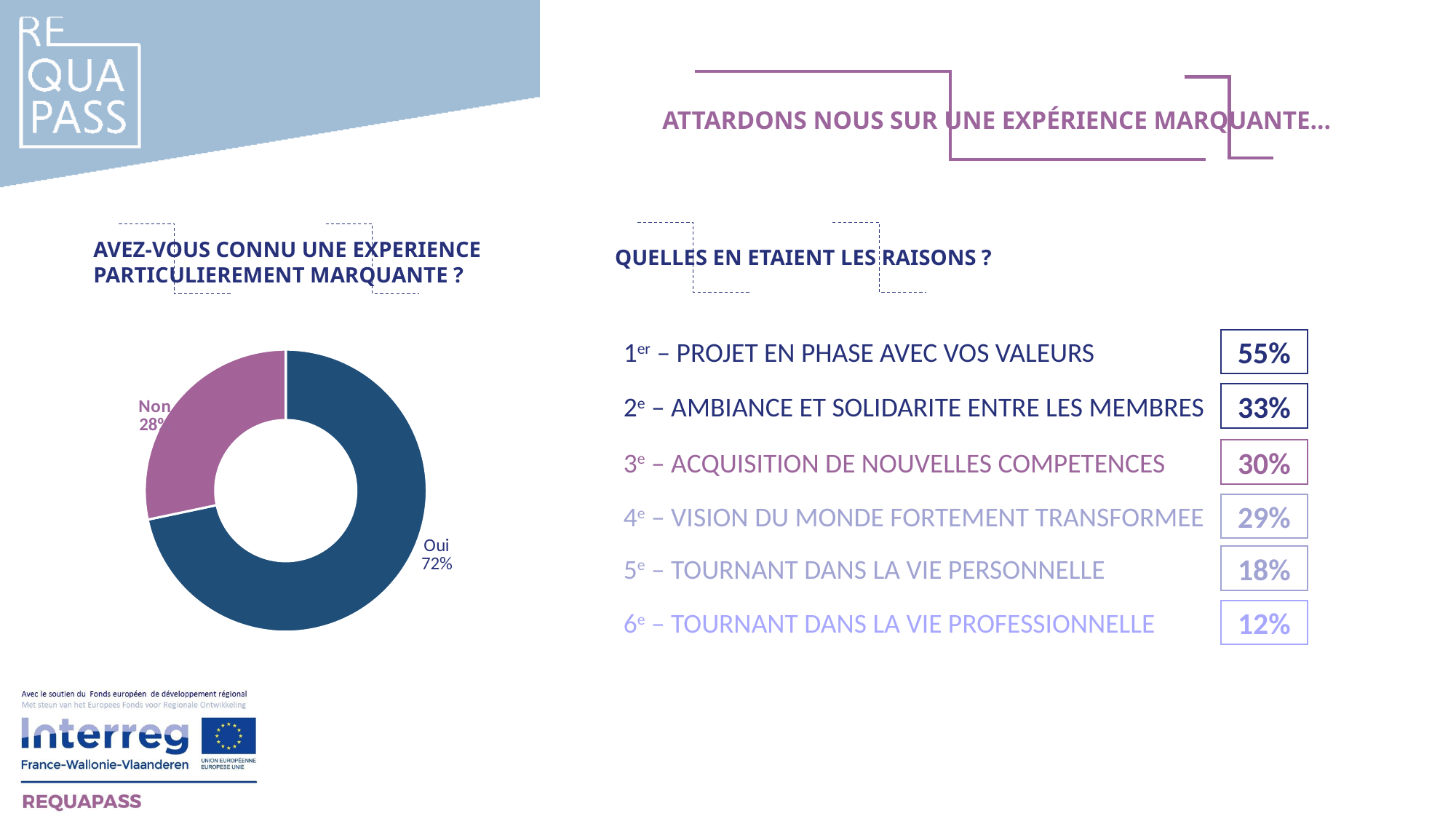
How many categories are shown in the pie chart? 2 What percentage of respondents answered "Non" in the pie chart? 28% What kind of chart is shown on the left of the slide? Pie chart (donut) What question does the pie chart answer, according to its title? AVEZ-VOUS CONNU UNE EXPERIENCE PARTICULIEREMENT MARQUANTE ? Which is larger in the pie chart, "Oui" or "Non"? Oui What percentage of respondents answered "Oui" in the pie chart? 72% What is the difference in percentage points between the "Oui" and "Non" slices? 44 What colour is the "Oui" slice in the pie chart? Dark blue Which category has the largest share in the pie chart? Oui What share of the pie does the "Non" slice represent? 28% Which category has the smallest share in the pie chart? Non